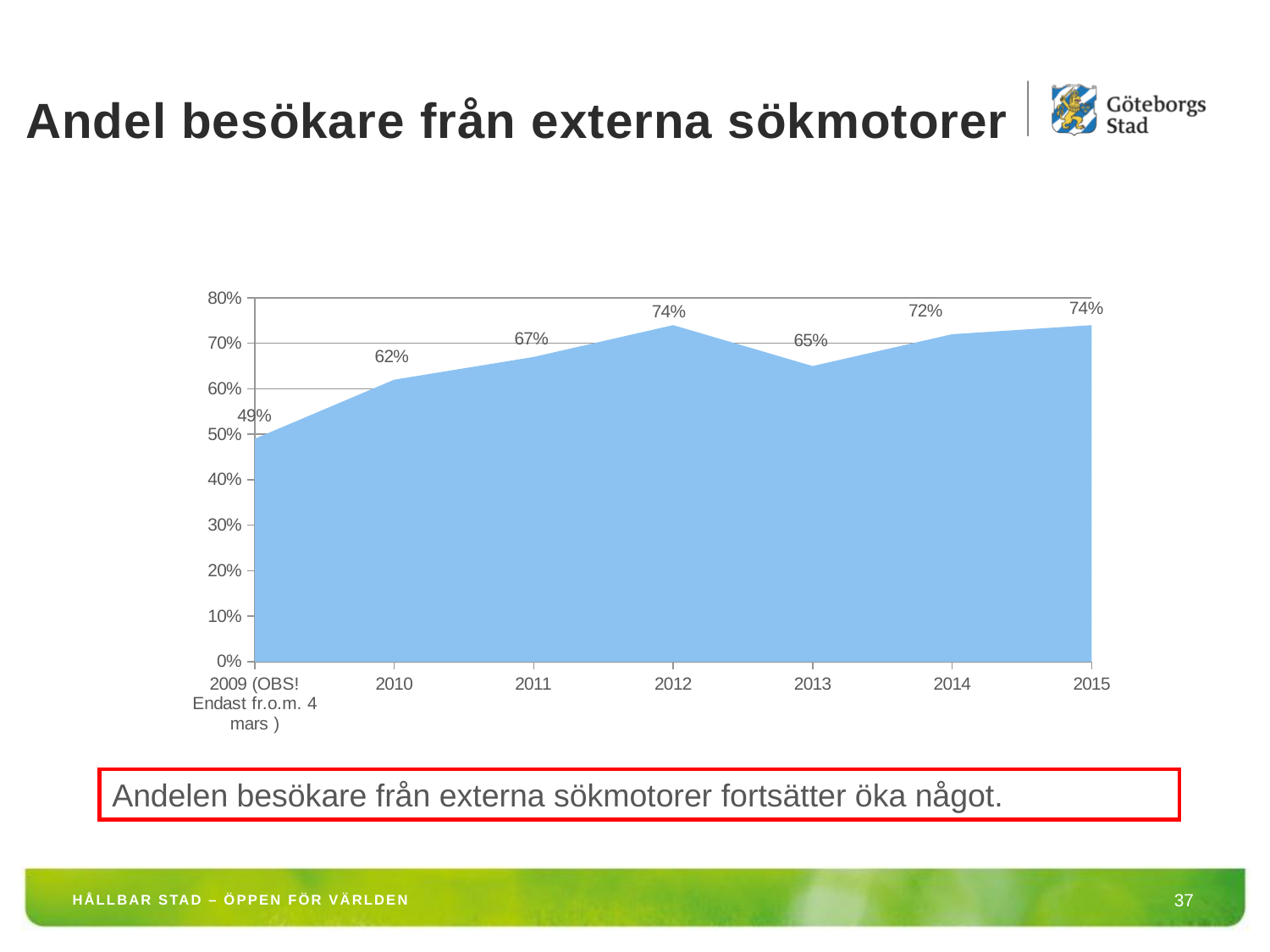
What is the value for 2014? 72% What is the title of the chart on the slide? Andel besökare från externa sökmotorer What is the difference between the values for 2012 and 2013? 9% How many years are plotted on the chart? 7 Is the value for 2014 greater or less than 60%? greater What is the value for 2010? 62% What is the value for 2013? 65% What is the difference between the values for 2015 and 2009? 25% What is the value for 2009? 49% Which is larger, the value for 2011 or the value for 2013? 2011 What kind of chart is shown on the slide? Area chart Which year has the lowest value? 2009